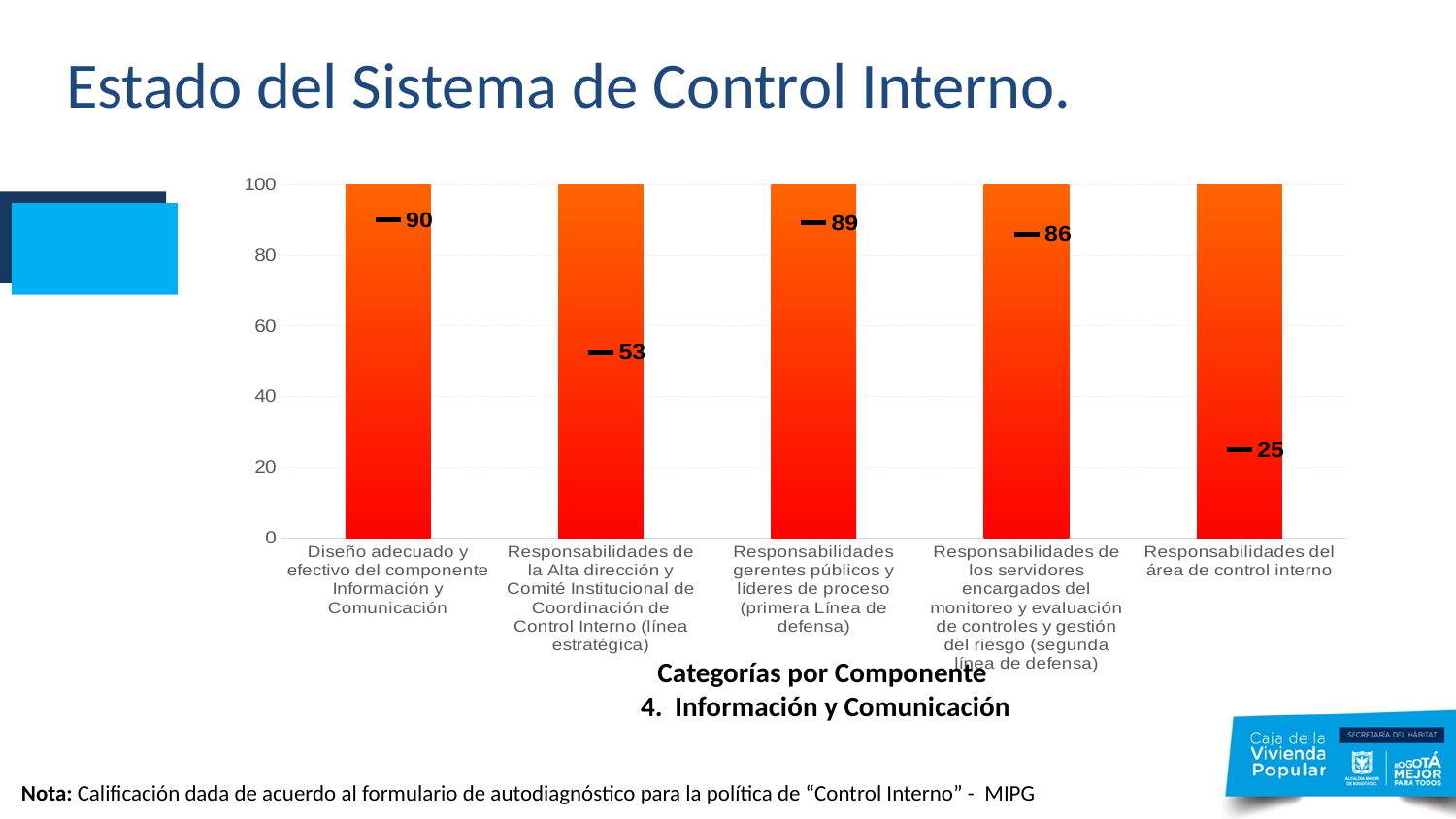
What is the title of the chart? Categorías por Componente 4. Información y Comunicación How many categories are shown on the x axis of the chart? 5 What is the value shown for 'Responsabilidades del área de control interno'? 25 Which category has the highest value? Diseño adecuado y efectivo del componente Información y Comunicación What is the value shown for 'Diseño adecuado y efectivo del componente Información y Comunicación'? 90 What value is shown for 'Responsabilidades de los servidores encargados del monitoreo y evaluación de controles y gestión del riesgo (segunda línea de defensa)'? 86 What value is shown for 'Responsabilidades gerentes públicos y líderes de proceso (primera Línea de defensa)'? 89 Which is larger: the value for 'Responsabilidades de la Alta dirección y Comité Institucional de Coordinación de Control Interno (línea estratégica)' or the value for 'Responsabilidades de los servidores encargados del monitoreo y evaluación de controles y gestión del riesgo (segunda línea de defensa)'? Responsabilidades de los servidores encargados del monitoreo y evaluación de controles y gestión del riesgo (segunda línea de defensa) What kind of chart is shown on the slide? Bar chart Which category has the lowest value? Responsabilidades del área de control interno What value is shown for 'Responsabilidades de la Alta dirección y Comité Institucional de Coordinación de Control Interno (línea estratégica)'? 53 What is the difference between the value for 'Diseño adecuado y efectivo del componente Información y Comunicación' and the value for 'Responsabilidades del área de control interno'? 65